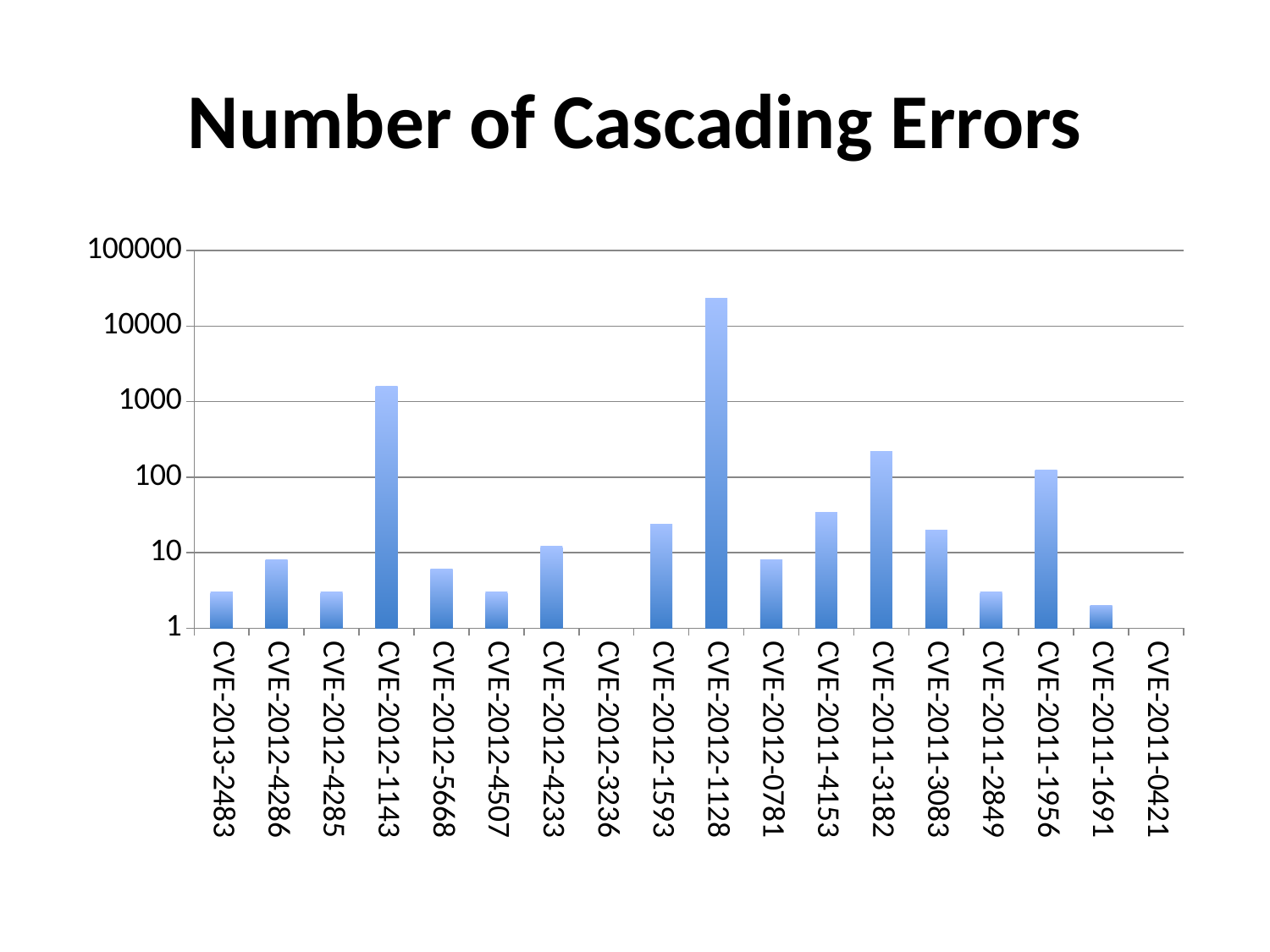
Which CVE has the highest number of cascading errors? CVE-2012-1128 Which has more cascading errors, CVE-2011-4153 or CVE-2012-0781? CVE-2011-4153 Is the value for CVE-2013-2483 greater or less than 10? less What is the highest value shown on the y axis? 100000 Is the value for CVE-2012-1143 greater or less than 1000? greater Is the value for CVE-2011-4153 greater or less than 10? greater Which has more cascading errors, CVE-2012-1143 or CVE-2011-3182? CVE-2012-1143 How many CVE categories are listed along the x axis? 18 What is the title of the chart? Number of Cascading Errors What kind of chart is shown on the slide? bar chart